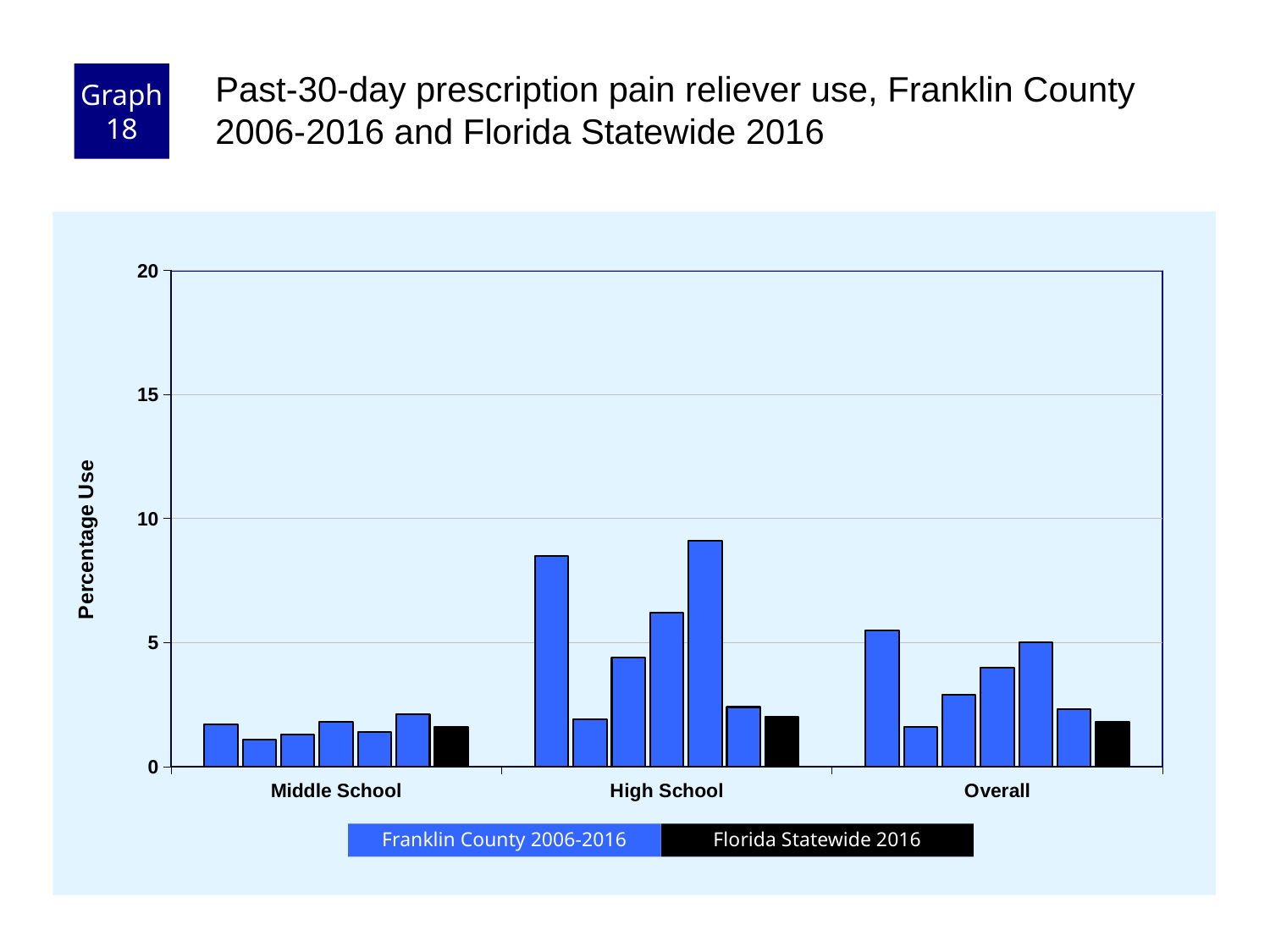
Is the tallest Franklin County 2006-2016 bar for High School greater or less than 5? greater How many series does the legend list? 2 Does any bar on the chart exceed 10? No Which category contains the tallest bar on the chart? High School Is the Florida Statewide 2016 value for Overall greater or less than 5? less What are the two series named in the legend? Franklin County 2006-2016 and Florida Statewide 2016 What kind of chart is shown on the slide? Bar chart Which is larger: the tallest bar in High School or the tallest bar in Overall? High School How many categories are shown on the x axis? 3 What is the label on the y axis? Percentage Use